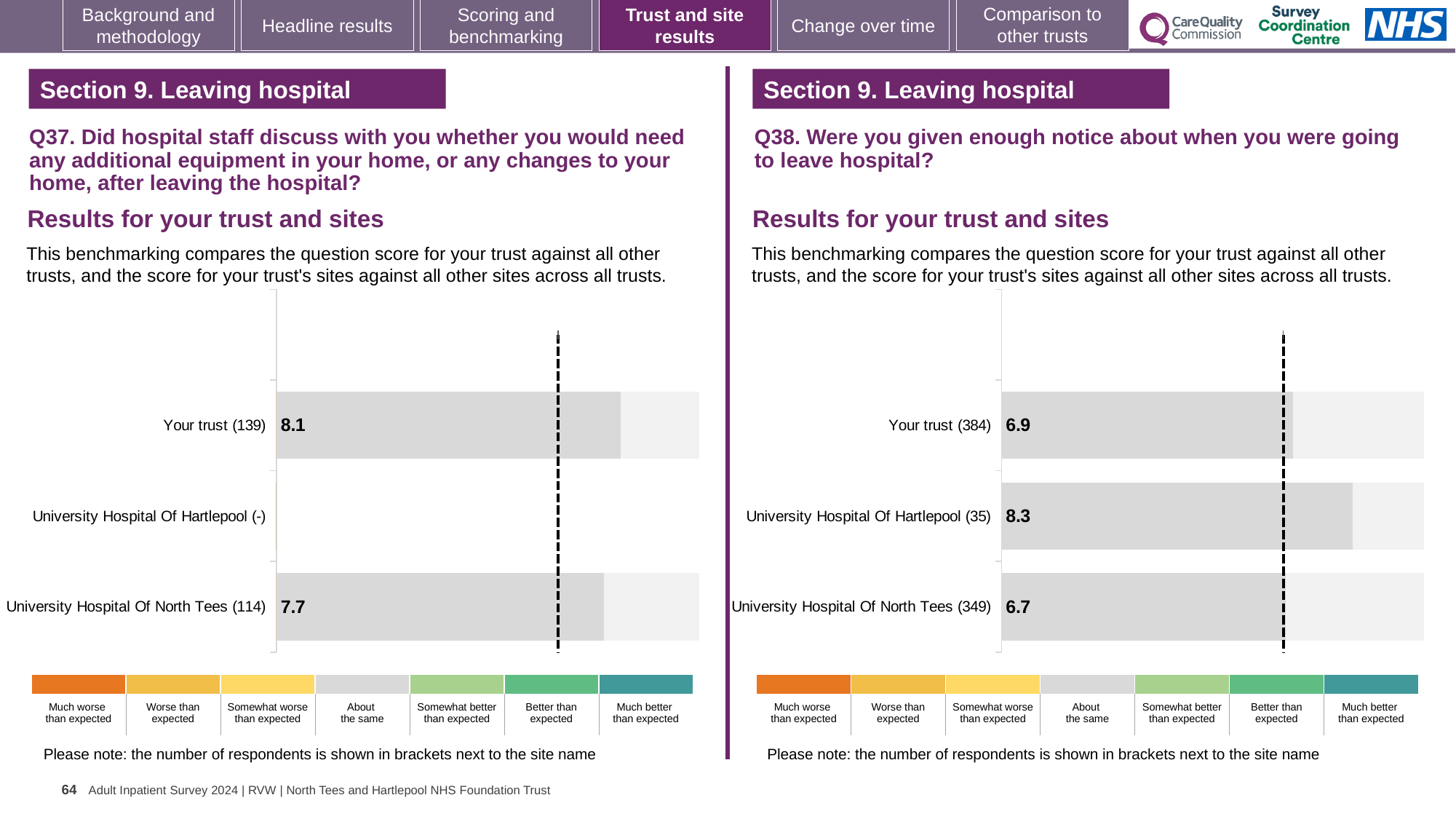
In the Q38 chart on the right, what is the difference between the score for University Hospital Of Hartlepool (35) and Your trust (384)? 1.4 In the Q37 chart on the left, what is the score for Your trust (139)? 8.1 In the Q37 chart on the left, what is the score for University Hospital Of North Tees (114)? 7.7 In the Q37 chart on the left, how many respondents are shown for Your trust? 139 In the Q38 chart on the right, what is the score for University Hospital Of Hartlepool (35)? 8.3 In the Q38 chart on the right, what is the score for University Hospital Of North Tees (349)? 6.7 What kind of chart is used in the Q38 chart on the right? Bar chart In the Q38 chart on the right, what is the score for Your trust (384)? 6.9 In the Q37 chart on the left, what is the difference between the score for Your trust (139) and University Hospital Of North Tees (114)? 0.4 In the Q38 chart on the right, which site or trust has the highest score? University Hospital Of Hartlepool (35) In the Q37 chart on the left, which has the larger score: Your trust (139) or University Hospital Of North Tees (114)? Your trust (139) In the Q38 chart on the right, which site or trust has the lowest score? University Hospital Of North Tees (349)